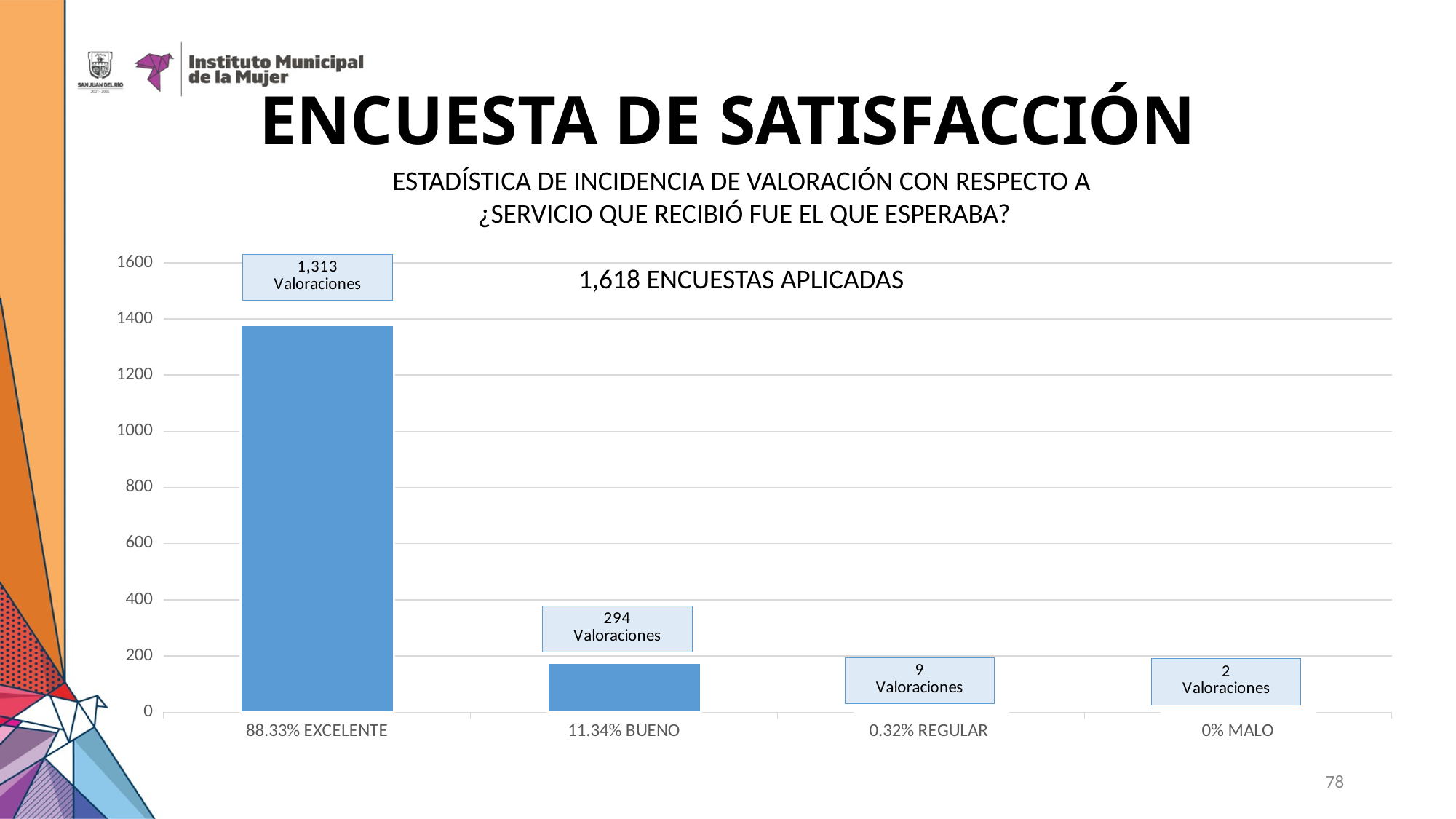
How many encuestas aplicadas does the chart state? 1,618 How many valoraciones are shown for the EXCELENTE category? 1,313 Valoraciones Which category has the lowest number of valoraciones? 0% MALO How many categories are shown on the x axis of the chart? 4 What kind of chart is shown on the slide? Bar chart What is the difference in valoraciones between EXCELENTE and BUENO? 1,019 Is the value for EXCELENTE greater or less than 1000? greater Which has more valoraciones, BUENO or REGULAR? BUENO How many valoraciones are shown for the REGULAR category? 9 Valoraciones How many valoraciones are shown for the MALO category? 2 Valoraciones How many valoraciones are shown for the BUENO category? 294 Valoraciones Which category has the highest number of valoraciones? 88.33% EXCELENTE